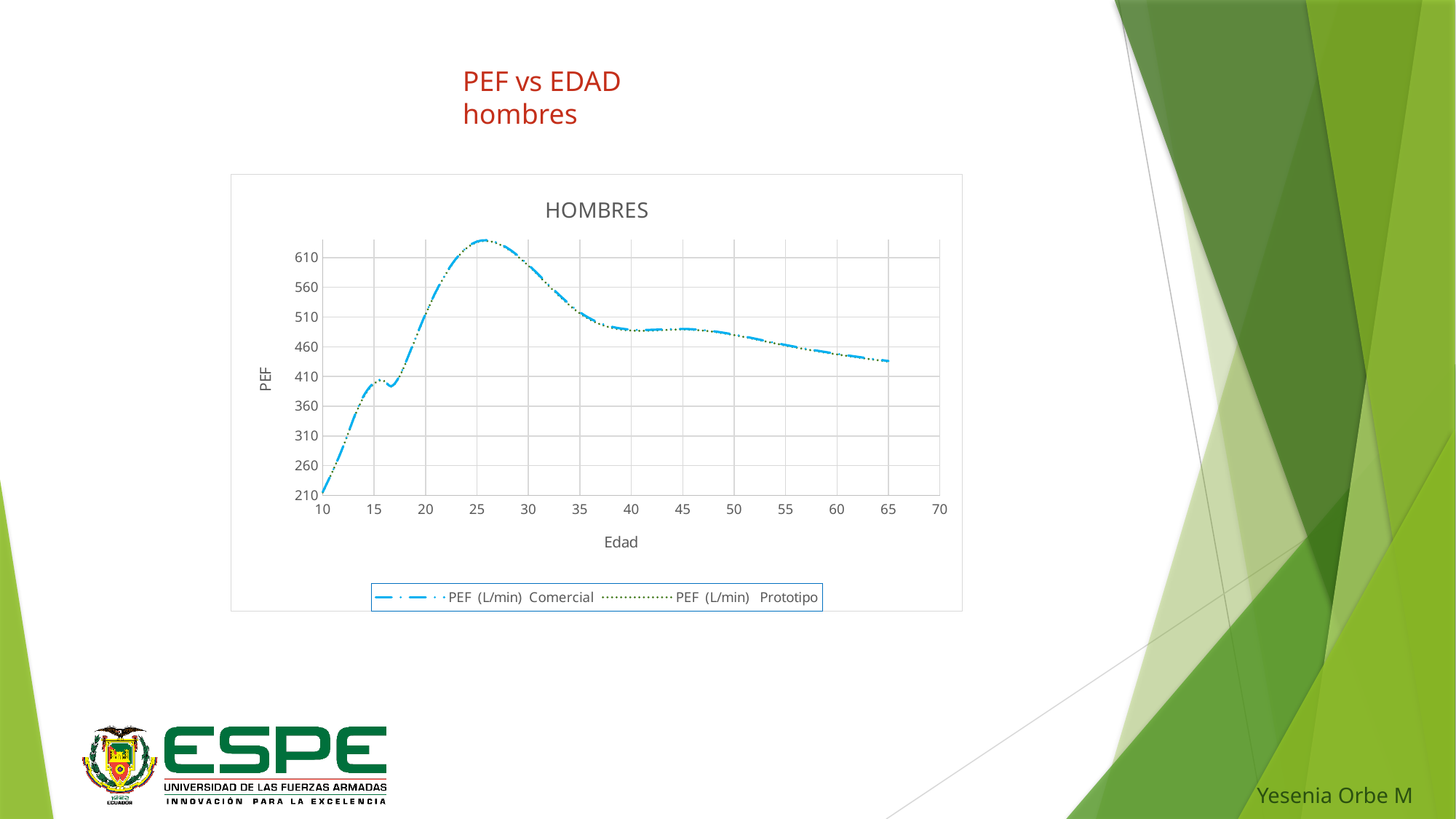
Is the peak PEF value of the curve greater or less than 610? greater How many series does the legend of the HOMBRES chart list? 2 What is the title of the chart? HOMBRES What kind of chart is shown on the slide? line chart Is the PEF value at age 50 greater or less than 460? greater Is the PEF value at age 30 greater or less than 560? greater What are the two series named in the legend? PEF (L/min) Comercial and PEF (L/min) Prototipo Between ages 10 and 25, does the PEF value rise or fall? rise Between ages 30 and 65, does the PEF value generally rise or fall? fall